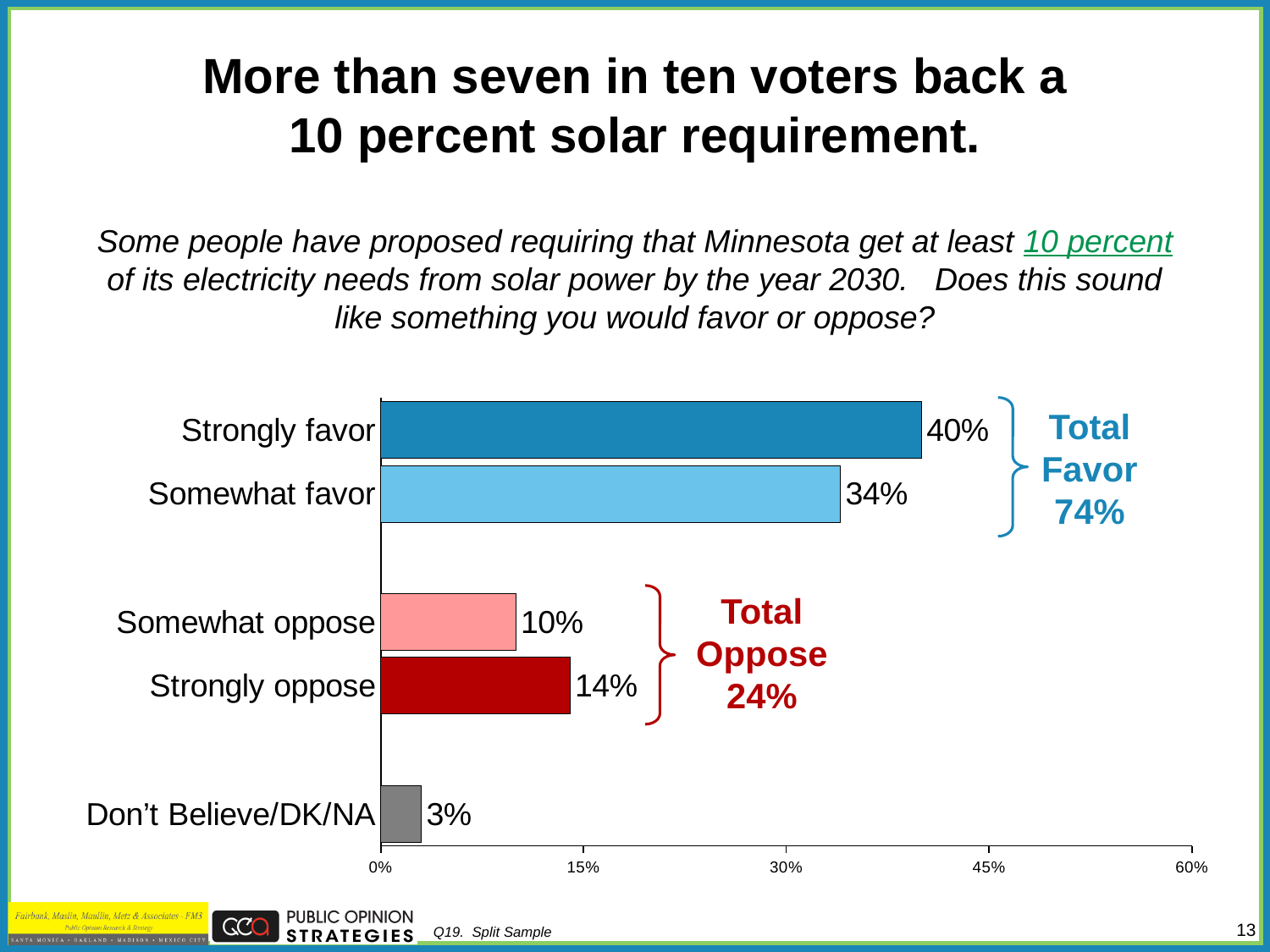
What is the Total Favor percentage shown on the chart? 74% What is the value for Somewhat favor? 34% Which category has the highest value? Strongly favor Which category has the lowest value? Don't Believe/DK/NA Which is larger, Somewhat oppose or Strongly oppose? Strongly oppose What is the value for Somewhat oppose? 10% What kind of chart is shown on the slide? Bar chart What is the difference between Strongly favor and Strongly oppose? 26% What is the value for Don't Believe/DK/NA? 3% How many categories are shown in the chart? 5 What percentage of voters strongly favor the 10 percent solar requirement? 40% What is the Total Oppose percentage shown on the chart? 24%